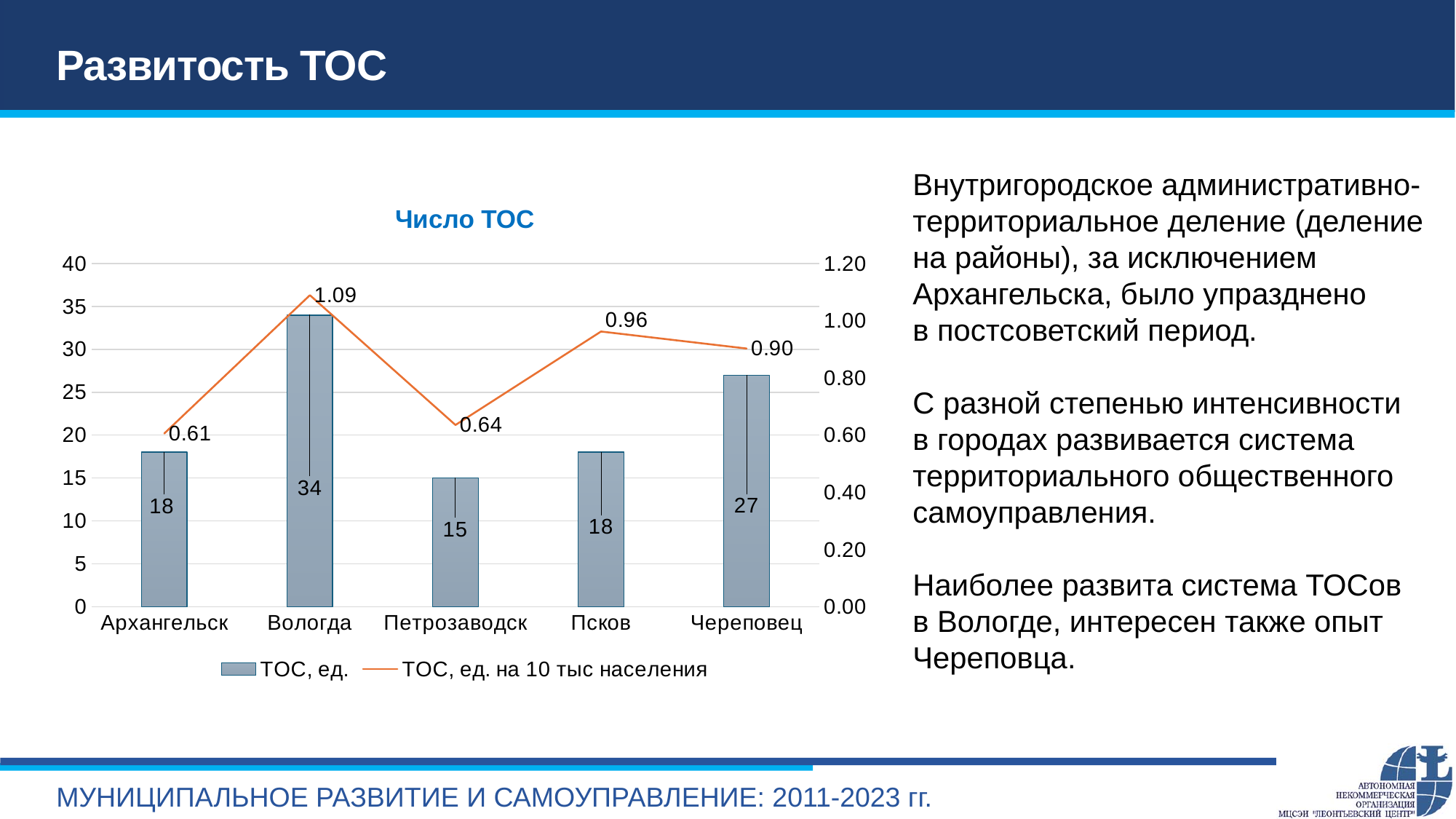
What is the value of ТОС, ед. for Вологда? 34 What is the title of the chart? Число ТОС Which city has the highest value of ТОС, ед.? Вологда What is the difference in ТОС, ед. between Вологда and Петрозаводск? 19 What kind of chart is used to show ТОС, ед.? Bar chart Which is larger, the ТОС, ед. на 10 тыс населения value for Псков or for Череповец? Псков Which city has the lowest value of ТОС, ед. на 10 тыс населения? Архангельск What is the value of ТОС, ед. на 10 тыс населения for Петрозаводск? 0.64 How many cities are shown on the x axis of the chart? 5 How many series does the legend list? 2 What is the value of ТОС, ед. for Череповец? 27 What is the value of ТОС, ед. на 10 тыс населения for Псков? 0.96